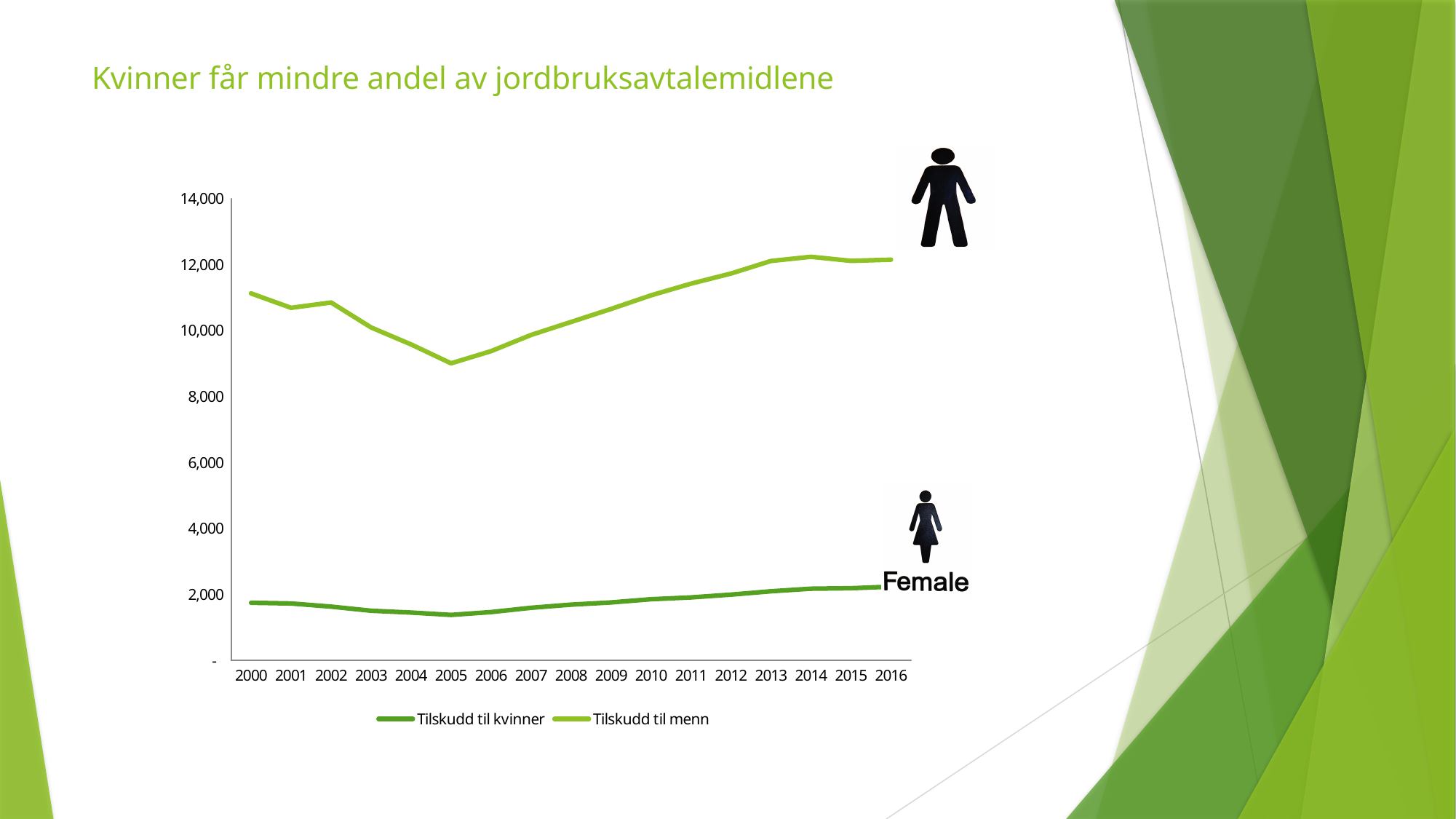
How many series does the legend list? 2 Is the value for Tilskudd til menn in 2005 greater or less than 10,000? less Does the value for Tilskudd til menn rise or fall between 2005 and 2013? Rise In which year is the value for Tilskudd til menn lowest? 2005 What are the two series named in the legend? Tilskudd til kvinner and Tilskudd til menn What is the title of the slide? Kvinner får mindre andel av jordbruksavtalemidlene Does the value for Tilskudd til menn rise or fall between 2000 and 2005? Fall How many years are shown on the x axis? 17 What kind of chart is shown on the slide? Line chart Which series has the higher value in 2016, Tilskudd til kvinner or Tilskudd til menn? Tilskudd til menn Is the value for Tilskudd til kvinner in 2005 greater or less than 2,000? less Is the value for Tilskudd til menn in 2000 greater or less than 10,000? greater